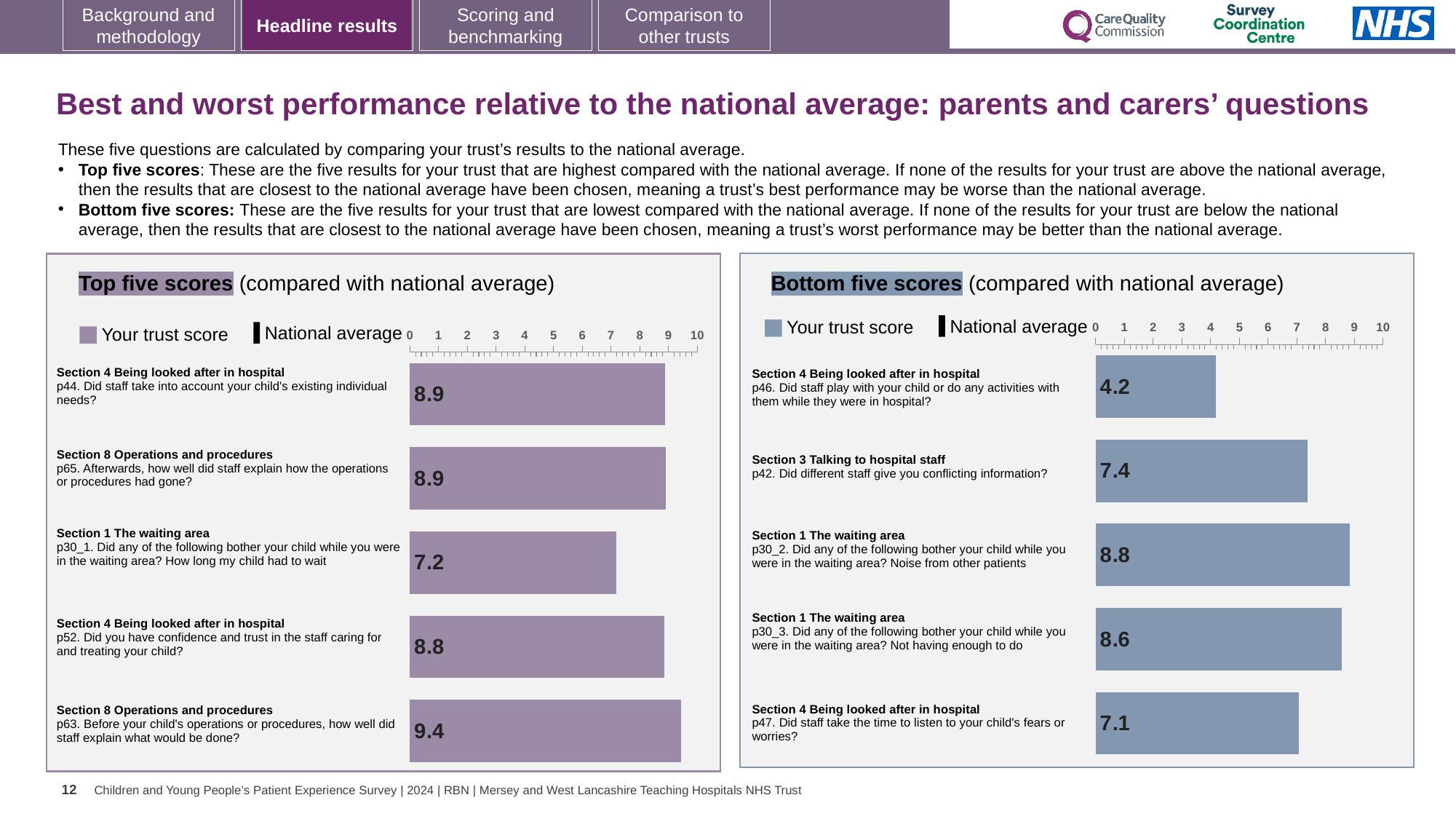
In the Top five scores chart, what is the trust score for p52 (Did you have confidence and trust in the staff caring for and treating your child?)? 8.8 In the Bottom five scores chart, which question has the lowest trust score? p46. Did staff play with your child or do any activities with them while they were in hospital? In the Top five scores chart, what is the difference between the trust score for p63 and the trust score for p30_1? 2.2 In the Top five scores chart, what is the trust score for p63 (Before your child's operations or procedures, how well did staff explain what would be done?)? 9.4 In the Bottom five scores chart, which question has the highest trust score? p30_2. Did any of the following bother your child while you were in the waiting area? Noise from other patients In the Bottom five scores chart, which has the larger trust score: p42 (Did different staff give you conflicting information?) or p47 (Did staff take the time to listen to your child's fears or worries?)? p42 In the Top five scores chart, which question has the highest trust score? p63. Before your child's operations or procedures, how well did staff explain what would be done? What kind of chart is the Bottom five scores chart? Bar chart In the Bottom five scores chart, what is the trust score for p46 (Did staff play with your child or do any activities with them while they were in hospital?)? 4.2 In the Bottom five scores chart, what is the difference between the trust score for p30_2 and the trust score for p46? 4.6 How many bars are plotted in the Top five scores chart? 5 In the Top five scores chart, which question has the lowest trust score? p30_1. Did any of the following bother your child while you were in the waiting area? How long my child had to wait